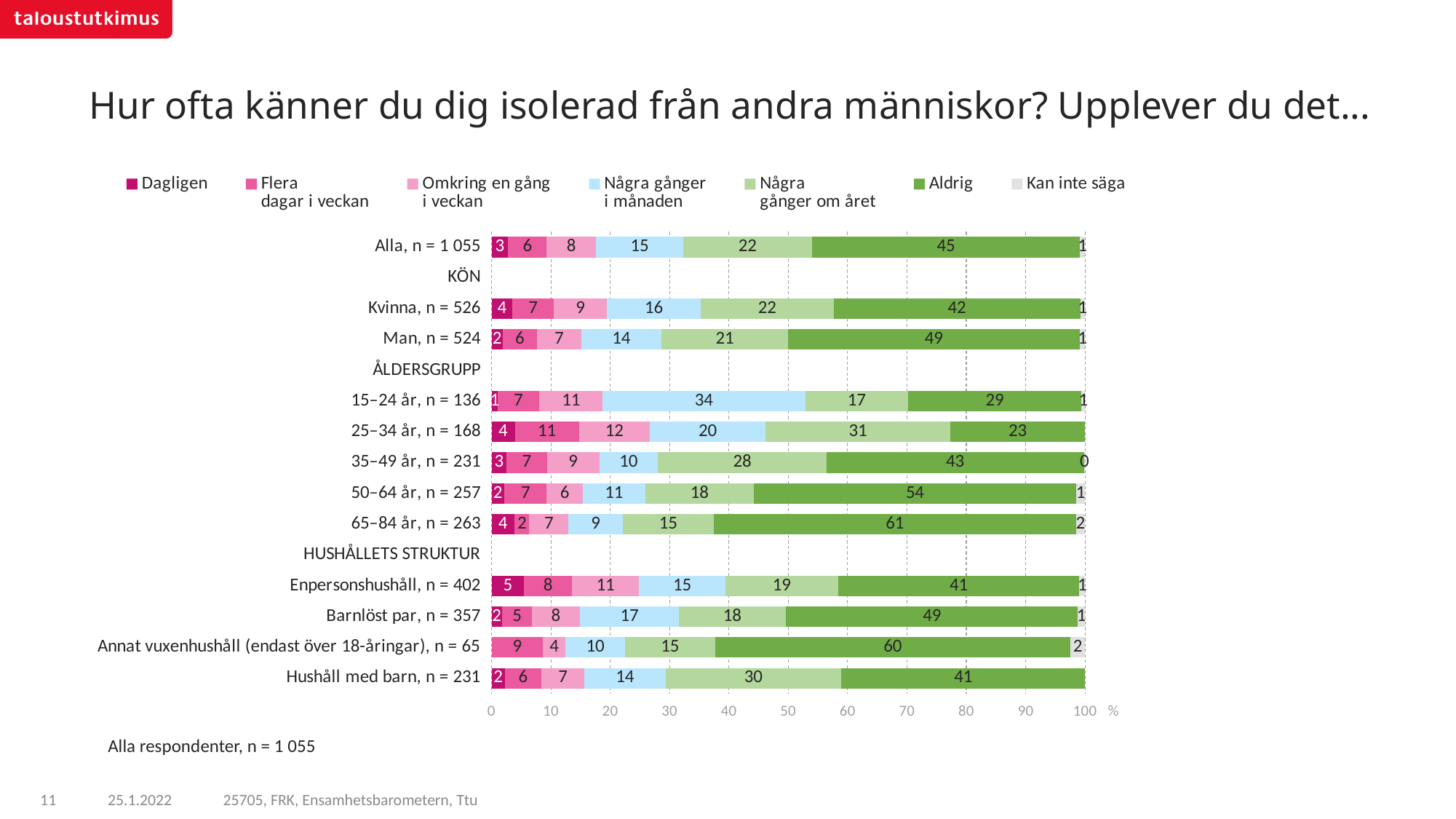
What kind of chart is shown on the slide? stacked bar chart What is the "Några gånger i månaden" value for "15–24 år, n = 136"? 34 Which has a larger "Några gånger om året" value, "Hushåll med barn, n = 231" or "Barnlöst par, n = 357"? Hushåll med barn, n = 231 How many respondent groups (bars) are plotted in the chart? 12 What is the difference between the "Aldrig" values for "Man, n = 524" and "Kvinna, n = 526"? 7 Which group has the lowest "Aldrig" value? 25–34 år, n = 168 What is the "Aldrig" value for "Annat vuxenhushåll (endast över 18-åringar), n = 65"? 60 How many series does the legend list? 7 Which group has the highest "Aldrig" value? 65–84 år, n = 263 What is the "Dagligen" value for "Enpersonshushåll, n = 402"? 5 What is the "Några gånger om året" value for "35–49 år, n = 231"? 28 What is the "Aldrig" value for "Alla, n = 1 055"? 45